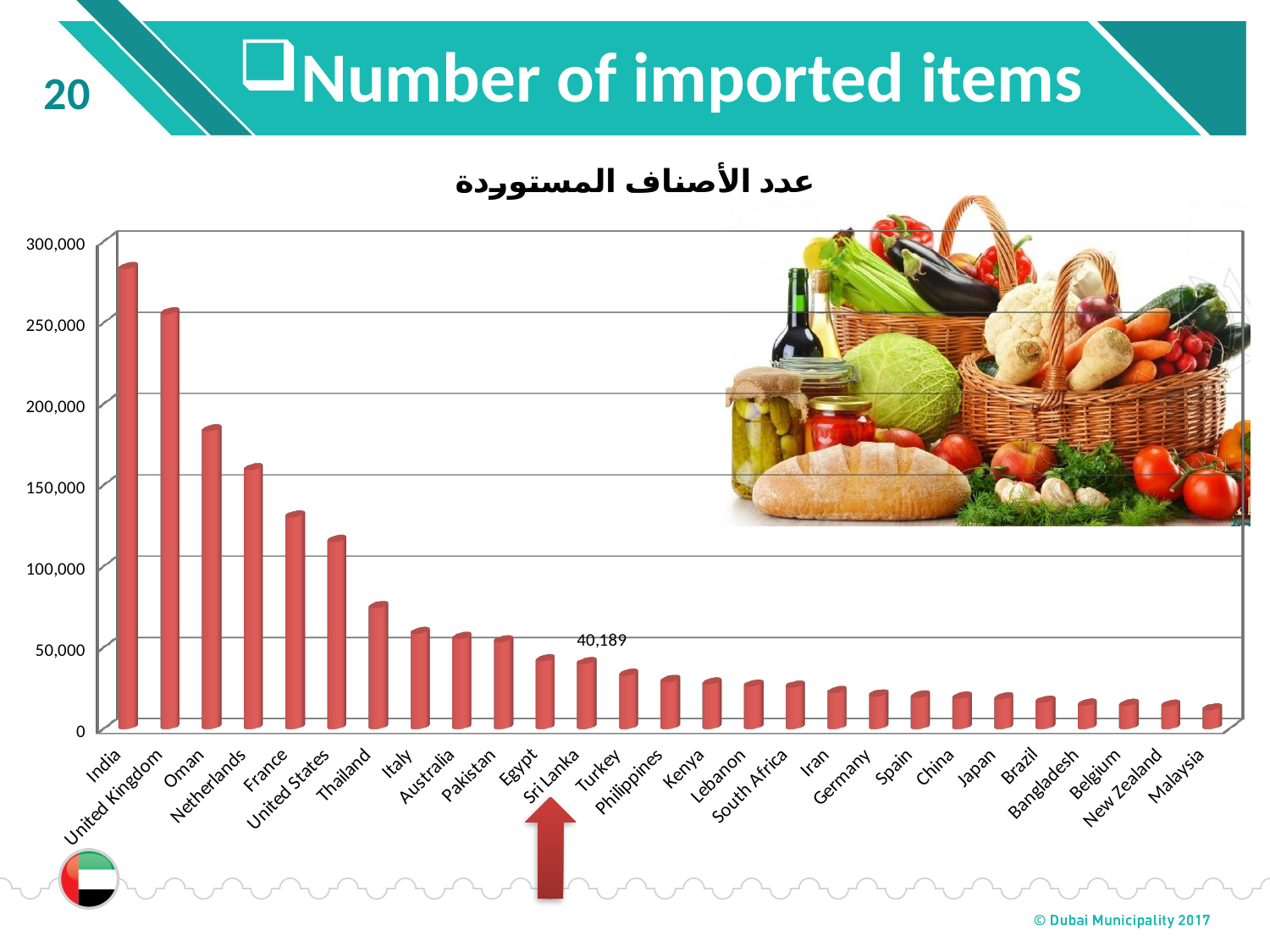
Which country's bar is marked with a red arrow below the chart? Sri Lanka Is the value for Egypt greater or less than 50,000? less What kind of chart is used on the slide? Bar chart Which country has the highest number of imported items? India Which has a larger value, India or United Kingdom? India Which country has the lowest number of imported items? Malaysia Is the value for India greater or less than 250,000? greater Do the values rise or fall moving from left to right along the x axis? Fall Which has a larger value, Oman or Netherlands? Oman Is the value for Thailand greater or less than 50,000? greater How many countries are shown on the x axis of the chart? 27 What is the value shown for Sri Lanka? 40,189